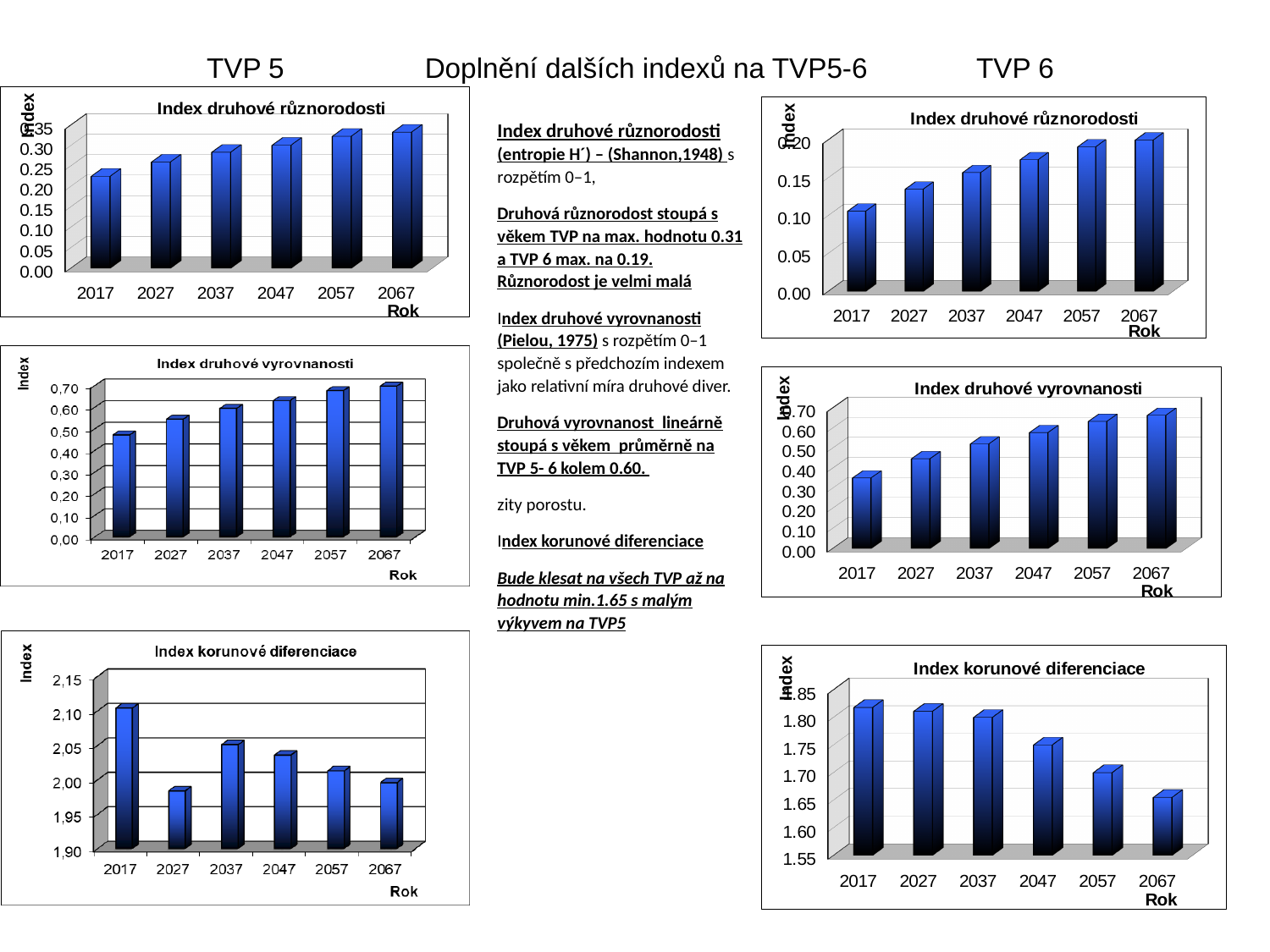
In the 'Index korunové diferenciace' chart on the right (TVP 6), do the values rise or fall from 2017 to 2067? fall In the 'Index druhové různorodosti' chart on the left (TVP 5), is the value for 2067 greater or less than 0.30? greater How many years are shown on the x axis of the 'Index korunové diferenciace' chart on the right (TVP 6)? 6 In the 'Index druhové různorodosti' chart on the right (TVP 6), is the value for 2017 greater or less than 0.15? less What is the label of the x axis on the 'Index druhové vyrovnanosti' chart on the right (TVP 6)? Rok In the 'Index korunové diferenciace' chart on the right (TVP 6), is the value for 2067 greater or less than 1.70? less What kind of chart is the 'Index druhové různorodosti' chart on the left (TVP 5)? bar chart In the 'Index korunové diferenciace' chart on the left (TVP 5), which year has the highest value? 2017 In the 'Index korunové diferenciace' chart on the left (TVP 5), which is larger, the value for 2017 or the value for 2027? 2017 In the 'Index druhové různorodosti' chart on the right (TVP 6), which year has the highest value? 2067 In the 'Index korunové diferenciace' chart on the right (TVP 6), which year has the lowest value? 2067 In the 'Index druhové vyrovnanosti' chart on the left (TVP 5), do the values rise or fall from 2017 to 2067? rise